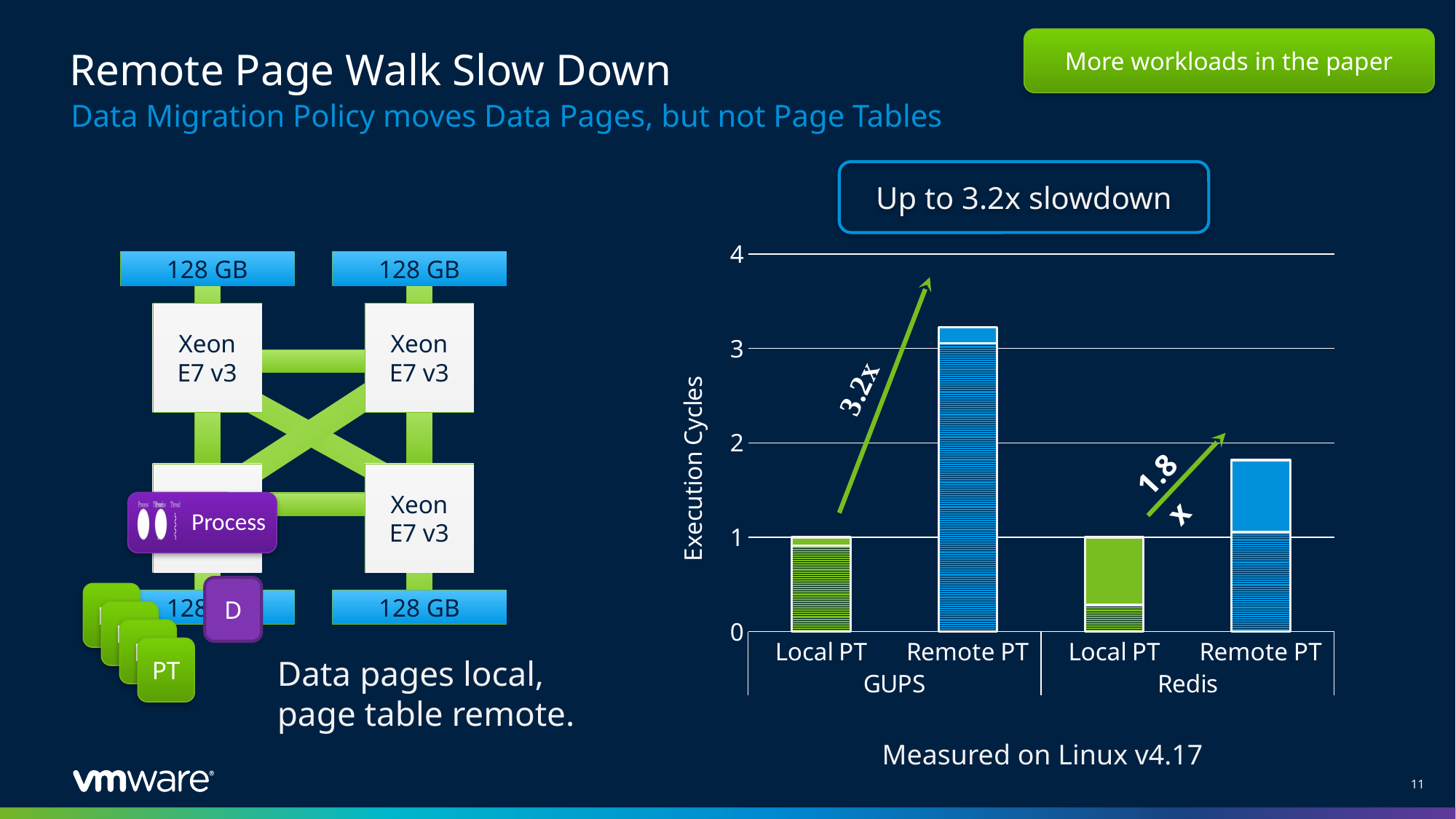
Which bar has the highest execution cycles? Remote PT (GUPS) Is the value for Remote PT under Redis greater or less than 2? less What is the value of the Local PT bar for GUPS? 1 Is the value for Remote PT under GUPS greater or less than 3? greater Which is larger: Remote PT for GUPS or Remote PT for Redis? Remote PT for GUPS Is the value for Remote PT under Redis greater or less than 1? greater What is the label of the y-axis of the chart? Execution Cycles What slowdown factor is annotated for GUPS in the chart? 3.2x What is the value of the Local PT bar for Redis? 1 How many bars are plotted in the chart? 4 What kind of chart is shown on the slide? bar chart What slowdown factor is annotated for Redis in the chart? 1.8x